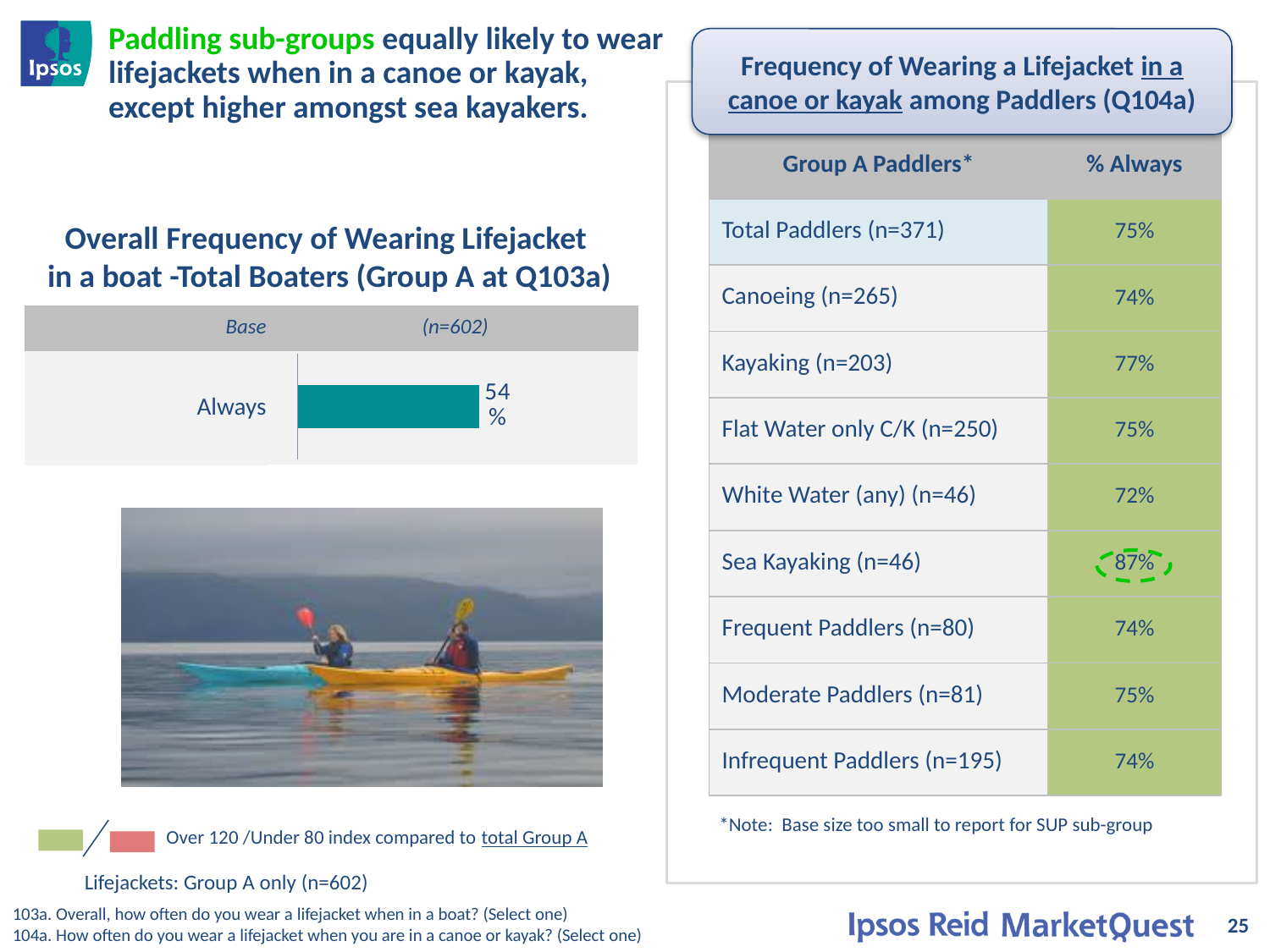
What base size is shown above the "Overall Frequency of Wearing Lifejacket in a boat" chart? (n=602) What kind of chart is used to show the overall frequency of wearing a lifejacket in a boat? bar chart How many categories are plotted in the "Overall Frequency of Wearing Lifejacket in a boat" chart? 1 Is the value for "Always" in the "Overall Frequency of Wearing Lifejacket in a boat" chart greater or less than 50%? greater What is the label of the single bar in the "Overall Frequency of Wearing Lifejacket in a boat" chart? Always In the chart titled "Overall Frequency of Wearing Lifejacket in a boat -Total Boaters (Group A at Q103a)", what value is shown for "Always"? 54%